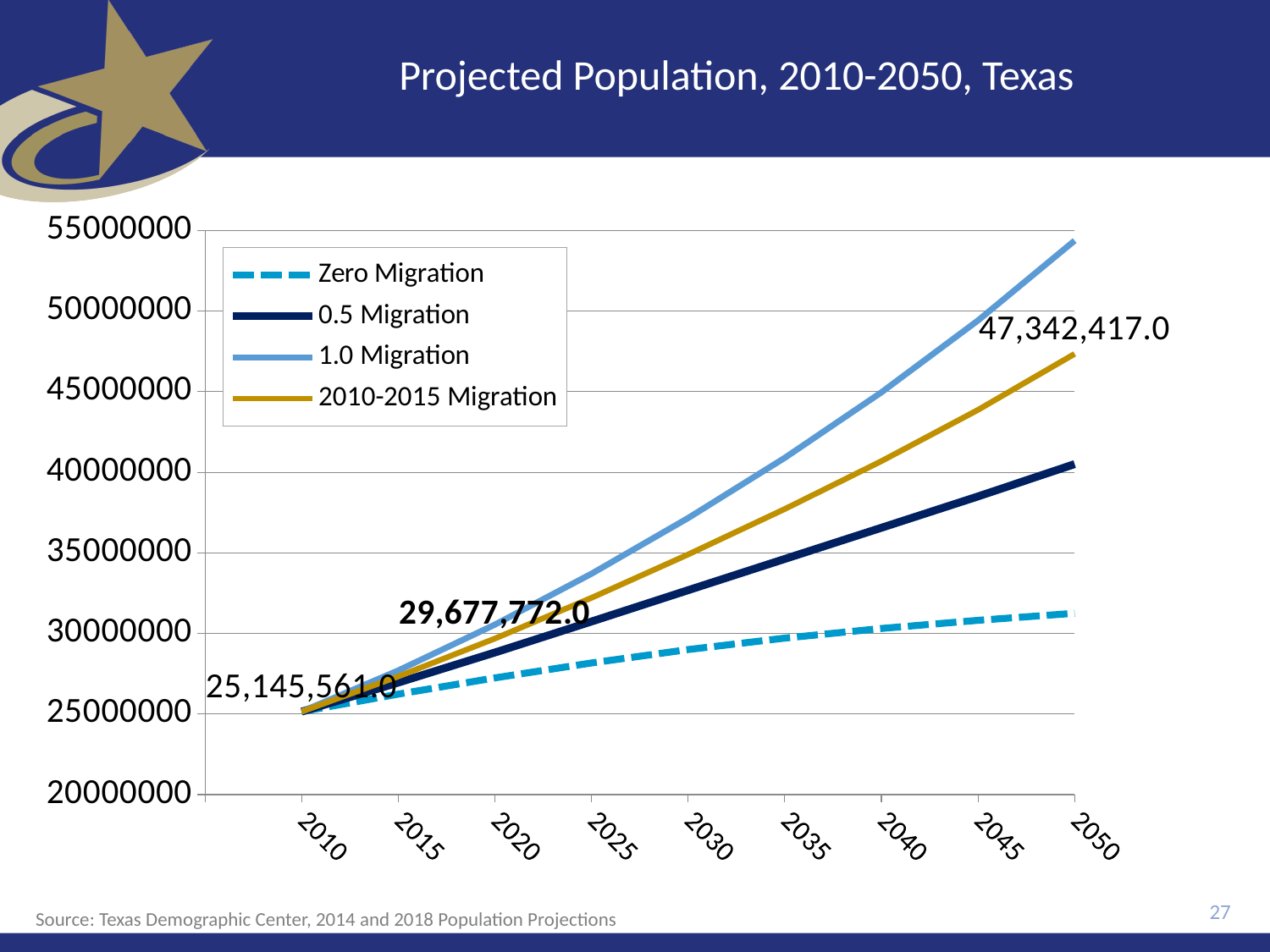
Do the projected population values rise or fall from 2010 to 2050? rise How many series does the legend list? 4 What kind of chart is shown on the slide? line chart What is the value labelled for the 2010-2015 Migration series at 2050? 47,342,417.0 Which series has the highest value at 2050? 1.0 Migration How many years are labelled along the x axis? 9 Is the value for 1.0 Migration at 2050 greater or less than 50000000? greater Is the value for Zero Migration at 2050 greater or less than 35000000? less What is the projected population value labelled at 2010? 25,145,561.0 Which series is drawn with a dashed line? Zero Migration At 2050, which is larger: the 2010-2015 Migration series or the 0.5 Migration series? 2010-2015 Migration Which series has the lowest value at 2050? Zero Migration